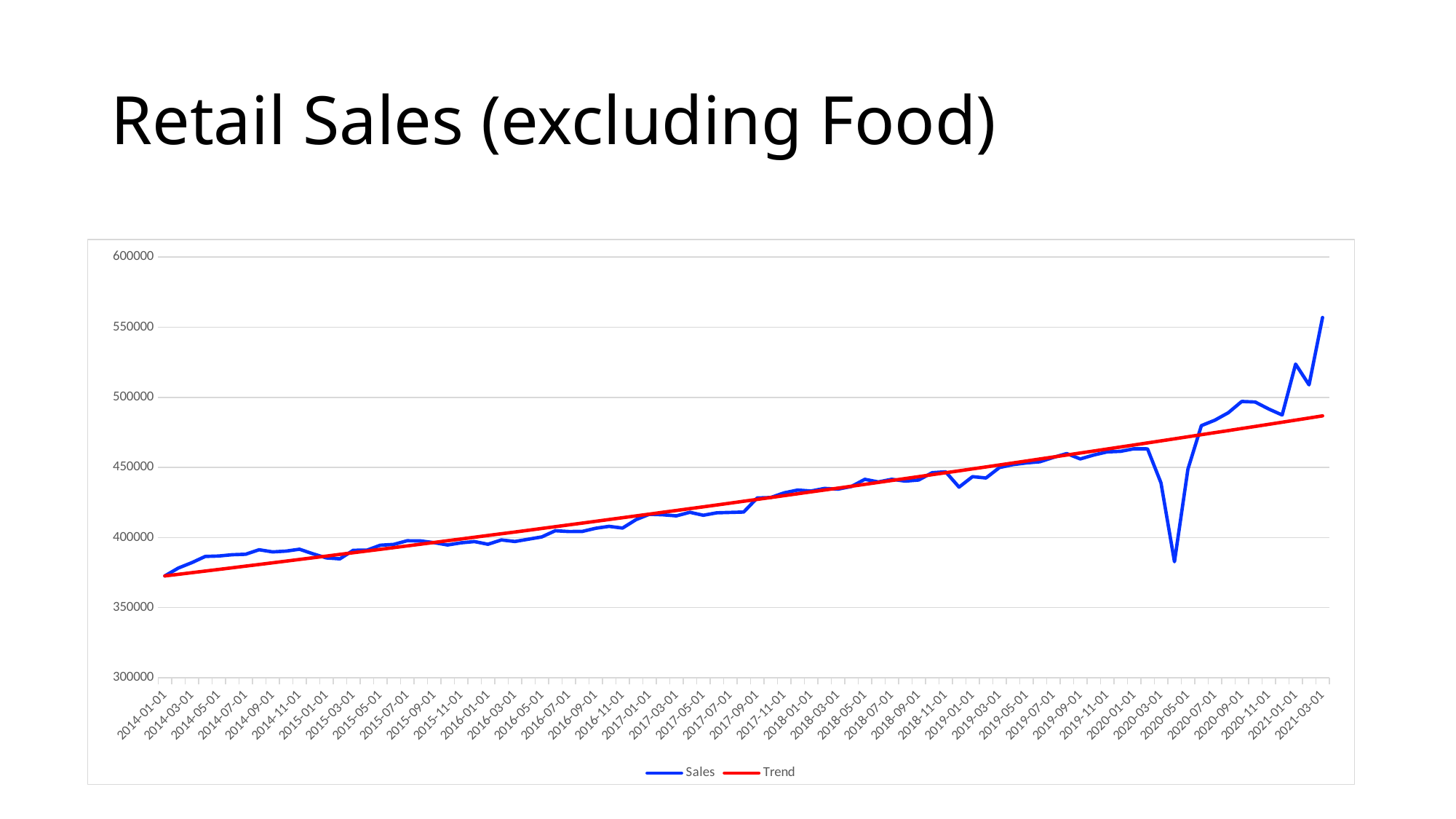
What is the title of the slide containing the chart? Retail Sales (excluding Food) Is the Sales value at 2021-03-01 greater or less than 500000? greater At 2021-03-01, which series has the larger value, Sales or Trend? Sales What are the two series named in the legend? Sales and Trend Is the Trend value at 2021-03-01 greater or less than 500000? less Is the Sales value at 2020-05-01 greater or less than 400000? greater At which date does the Sales series reach its highest value? 2021-03-01 How many series does the legend list? 2 Do the Sales values generally rise or fall from 2014-01-01 to 2021-03-01? rise What kind of chart is shown on the slide? line chart At 2020-05-01, which series has the larger value, Sales or Trend? Trend